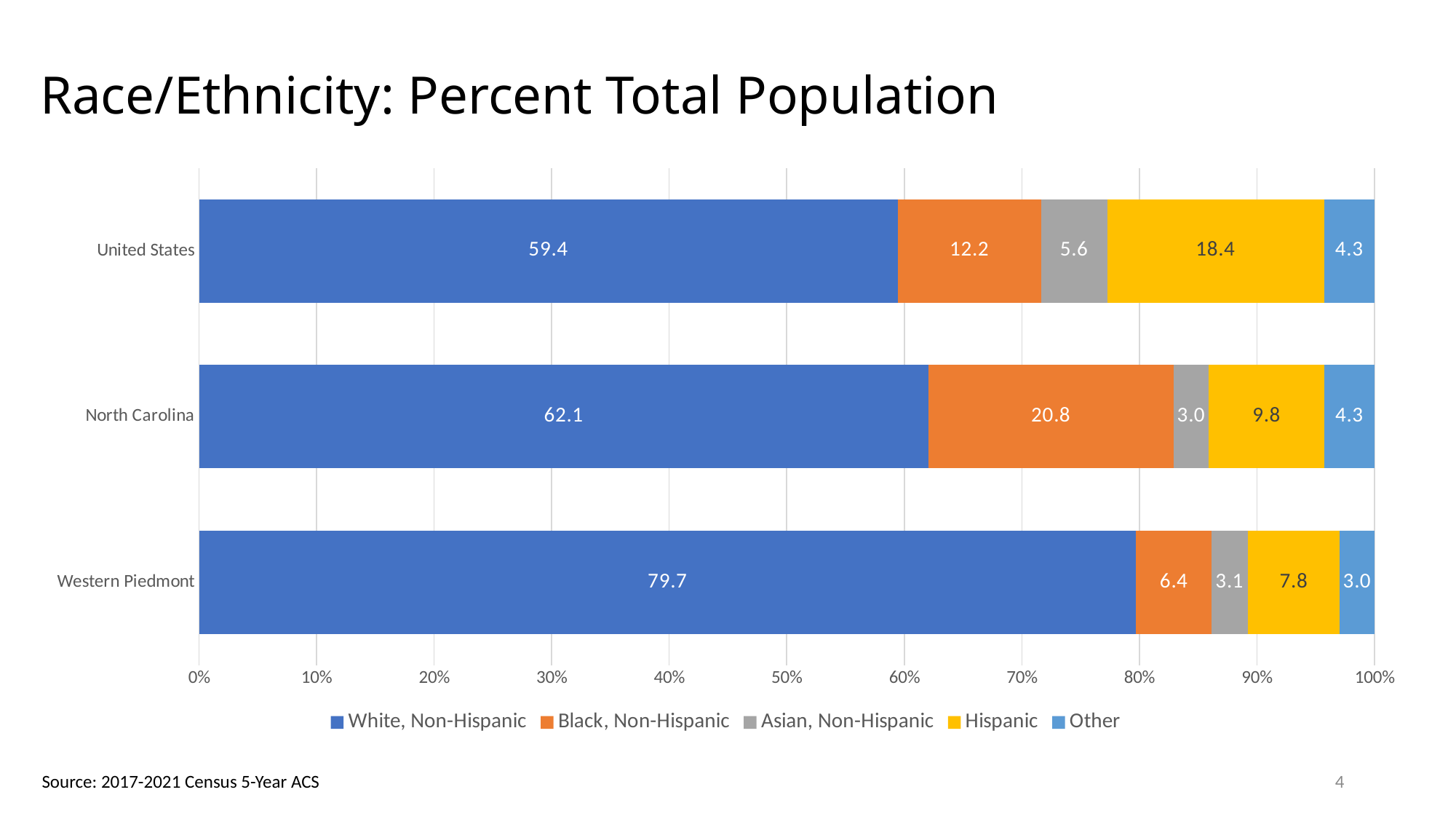
What is the Hispanic percentage for the United States? 18.4 How many regions are shown on the chart? 3 What is the Asian, Non-Hispanic percentage for Western Piedmont? 3.1 What is the Black, Non-Hispanic percentage for North Carolina? 20.8 What is the difference between the Black, Non-Hispanic percentage for North Carolina and for the United States? 8.6 How many series does the legend list? 5 Which is larger, the Hispanic percentage for North Carolina or for the United States? United States What kind of chart is shown on the slide? Stacked bar chart What is the White, Non-Hispanic percentage for Western Piedmont? 79.7 What colour represents the Hispanic series? Yellow Which region has the lowest Hispanic percentage? Western Piedmont Which region has the highest White, Non-Hispanic percentage? Western Piedmont